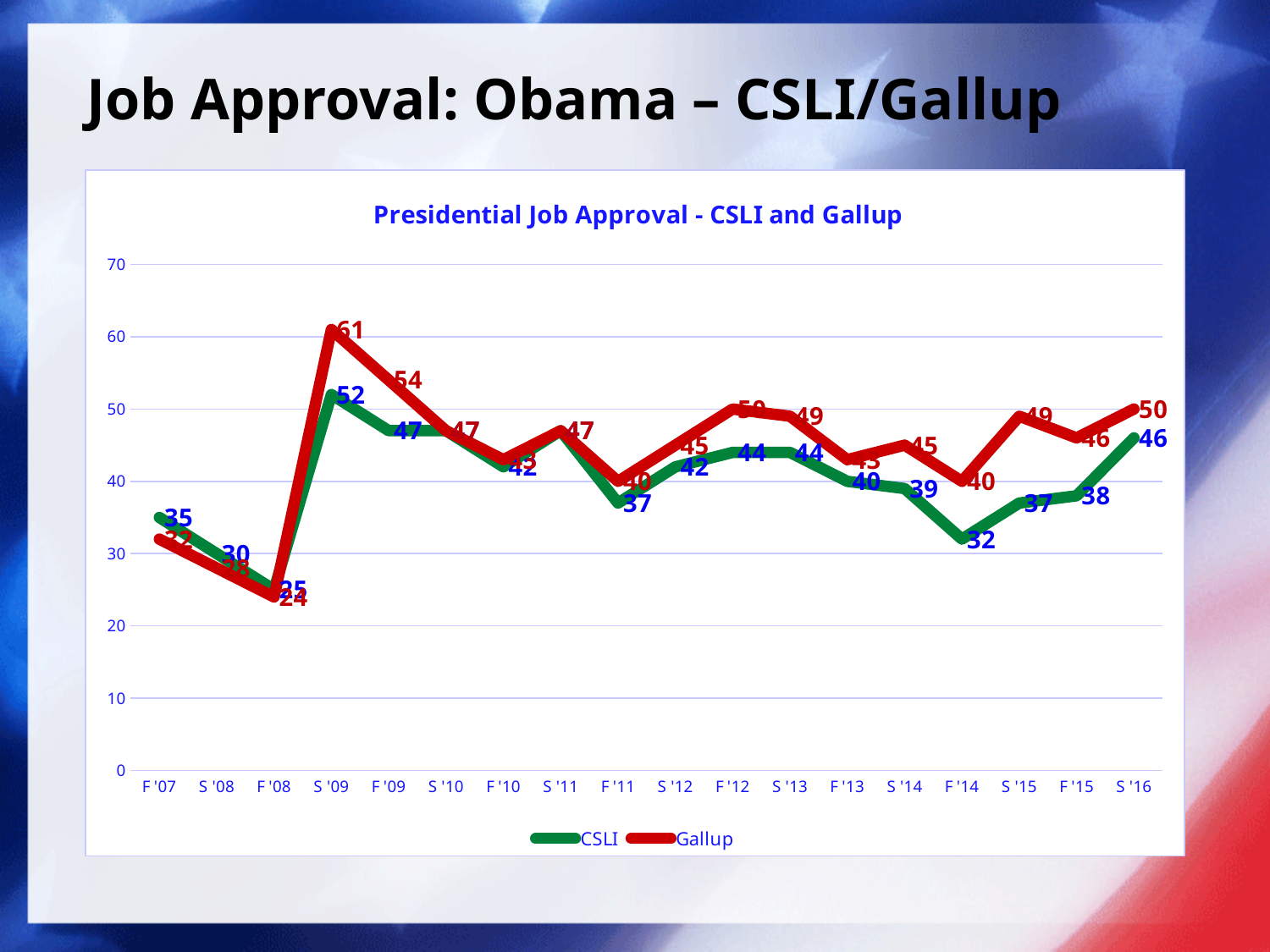
Does the CSLI series rise or fall from F '07 to F '08? fall What is the difference between the Gallup and CSLI values at S '09? 9 What is the CSLI value for S '09? 52 How many series does the legend list? 2 What is the title of the chart? Presidential Job Approval - CSLI and Gallup At S '16, which series has the higher value, CSLI or Gallup? Gallup At which time point does the CSLI series reach its lowest value? F '08 How many time points are plotted along the x axis? 18 At which time point does the Gallup series reach its highest value? S '09 What is the CSLI value for F '14? 32 What is the Gallup value for S '09? 61 What kind of chart is shown on the slide? line chart